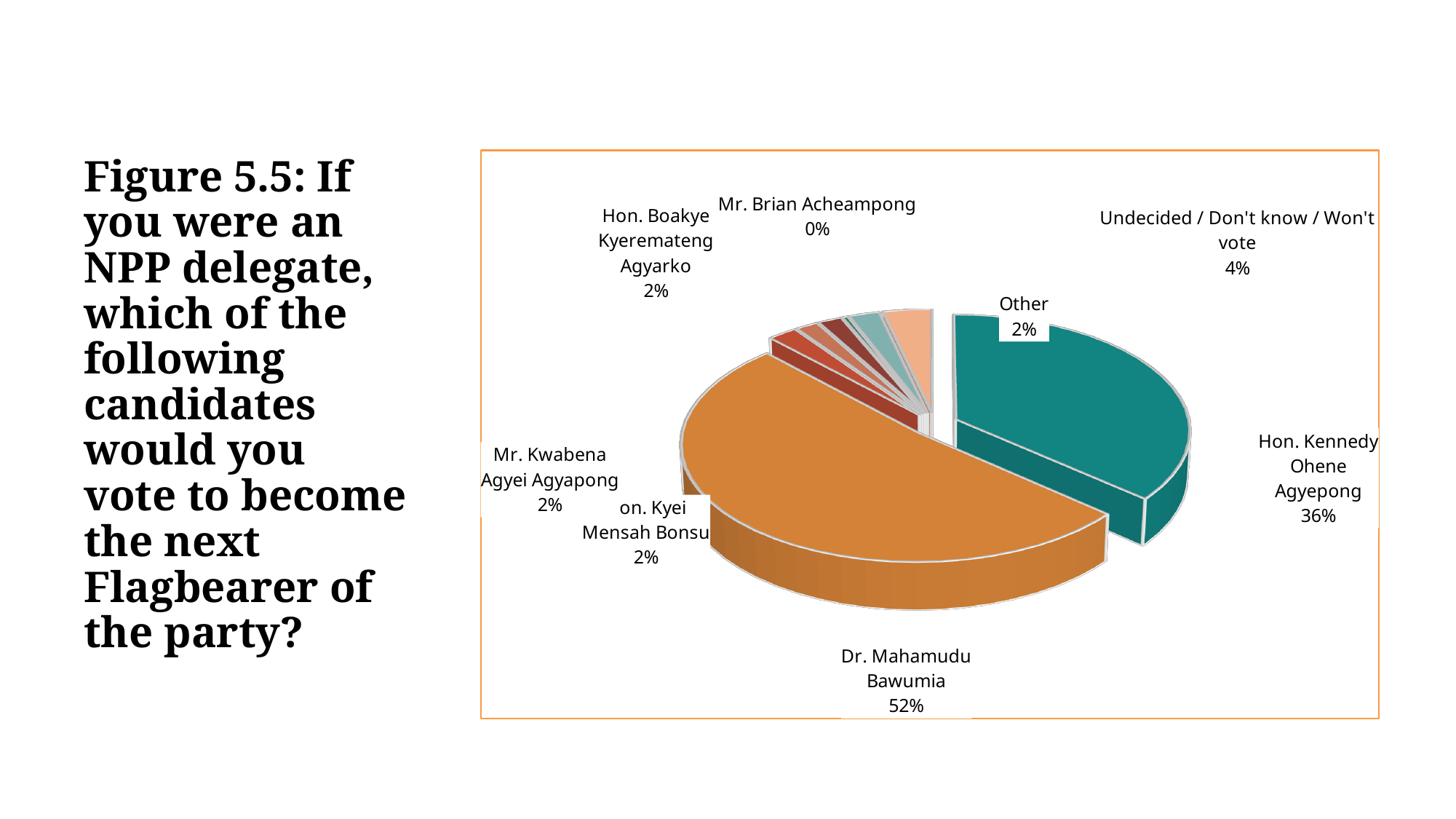
What colour is the slice for Hon. Kennedy Ohene Agyepong? Teal What percentage is shown for Mr. Brian Acheampong? 0% What share of the pie does Dr. Mahamudu Bawumia have? 52% What kind of chart is shown on the slide? Pie chart Which category has the smallest share of the pie? Mr. Brian Acheampong What is the difference in percentage points between Dr. Mahamudu Bawumia and Hon. Kennedy Ohene Agyepong? 16 Which is larger, the share for Undecided / Don't know / Won't vote or the share for Other? Undecided / Don't know / Won't vote What percentage is shown for Undecided / Don't know / Won't vote? 4% What share of the pie does Hon. Kennedy Ohene Agyepong have? 36% What percentage is shown for Hon. Boakye Kyeremateng Agyarko? 2% Which candidate has the largest slice of the pie? Dr. Mahamudu Bawumia How many categories are shown in the pie chart? 8